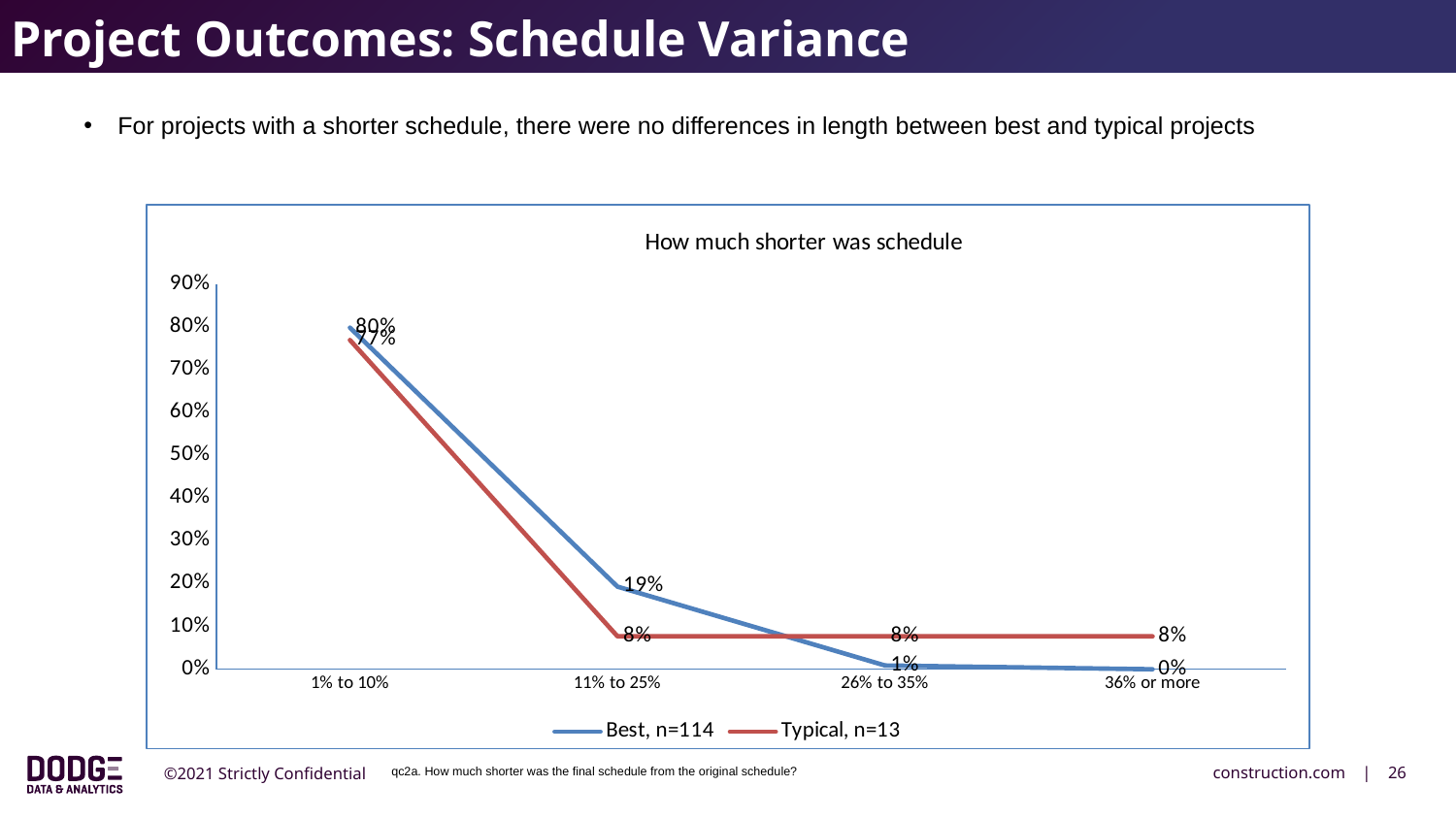
Which category has the highest value for Best, n=114? 1% to 10% What type of chart is shown on the slide? line chart What is the value for Best, n=114 in the 11% to 25% category? 19% What is the difference between Best, n=114 and Typical, n=13 in the 11% to 25% category? 11% Which category has the lowest value for Best, n=114? 36% or more Does the Best, n=114 series rise or fall from 1% to 10% to 36% or more? fall What is the value for Typical, n=13 in the 36% or more category? 8% What is the title of the chart? How much shorter was schedule How many series does the legend list? 2 What is the value for Typical, n=13 in the 1% to 10% category? 77% How many categories are shown on the x axis? 4 What is the value for Best, n=114 in the 1% to 10% category? 80%